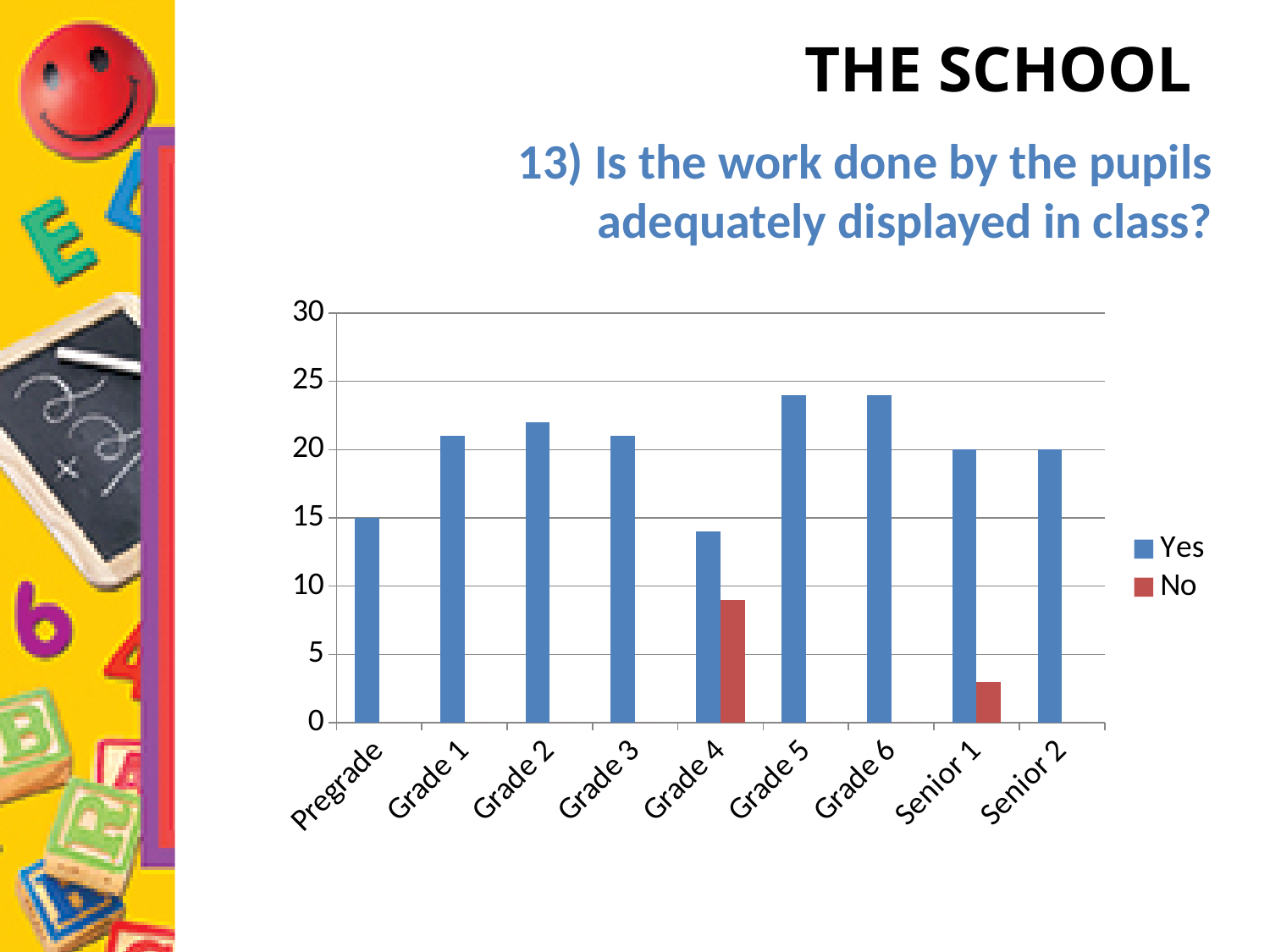
Is the Yes value for Grade 5 greater or less than 20? greater Is the Yes value for Grade 2 greater or less than 20? greater How many series does the legend list? 2 What is the Yes value for Pregrade? 15 Which has a larger Yes value, Grade 5 or Pregrade? Grade 5 How many grade categories are shown on the x axis? 9 What is the Yes value for Senior 2? 20 Is the No value for Grade 4 greater or less than 10? less Which categories show a visible No bar? Grade 4 and Senior 1 What colour represents the No series in the legend? red What kind of chart is shown on the slide? bar chart